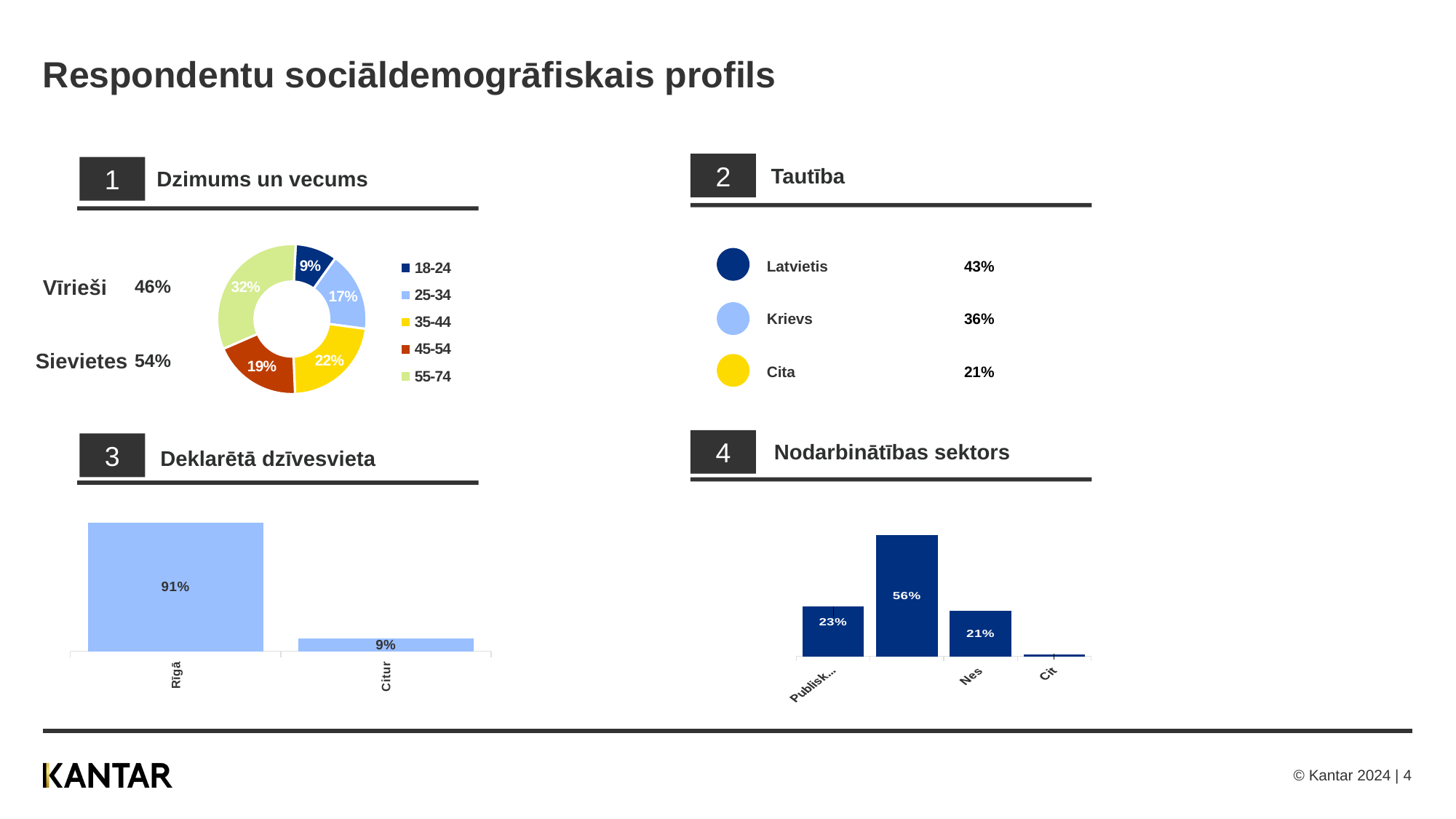
In the 'Nodarbinātības sektors' bar chart, what is the value for the bar labelled 'Nes'? 21% In the 'Deklarētā dzīvesvieta' bar chart, what is the difference between Rīgā and Citur? 82% In the 'Dzimums un vecums' donut chart, which is larger: the 35-44 share or the 45-54 share? 35-44 In the 'Dzimums un vecums' donut chart, what is the difference between the 35-44 and 18-24 shares? 13% In the 'Dzimums un vecums' donut chart, what share is the 25-34 age group? 17% In the 'Nodarbinātības sektors' bar chart, what is the value of the tallest bar? 56% In the 'Dzimums un vecums' donut chart, which age group has the largest share? 55-74 In the 'Dzimums un vecums' donut chart, what share is the 45-54 age group? 19% In the 'Dzimums un vecums' donut chart, which age group has the smallest share? 18-24 In the 'Deklarētā dzīvesvieta' bar chart, what is the value for Rīgā? 91% In the 'Dzimums un vecums' donut chart, how many age groups does the legend list? 5 What kind of chart is used in the 'Deklarētā dzīvesvieta' section? Bar chart